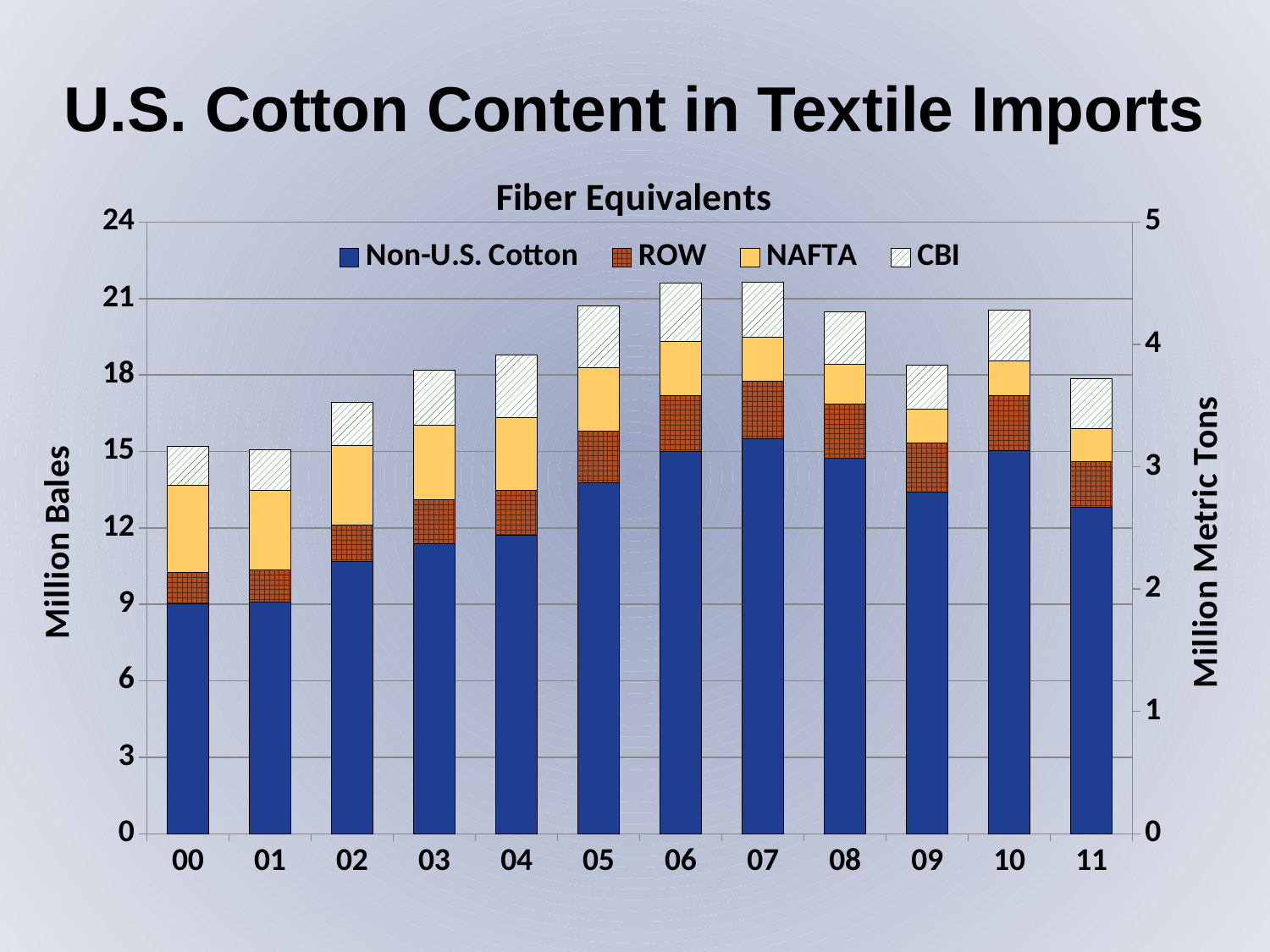
Is the Non-U.S. Cotton value for 05 greater or less than 12 million bales? greater What kind of chart is shown on the slide? Stacked bar chart What is the label of the left vertical axis? Million Bales How many series does the chart's legend list? 4 Is the total stacked bar for 02 greater or less than 18 million bales? less Which year has the larger total stacked bar, 01 or 06? 06 Which year has the larger Non-U.S. Cotton value, 02 or 05? 05 Do the total stacked bars rise or fall from 00 to 07? rise Is the total stacked bar for 06 greater or less than 21 million bales? greater What is the title printed above the chart's plot area? Fiber Equivalents How many years are shown along the x axis of the chart? 12